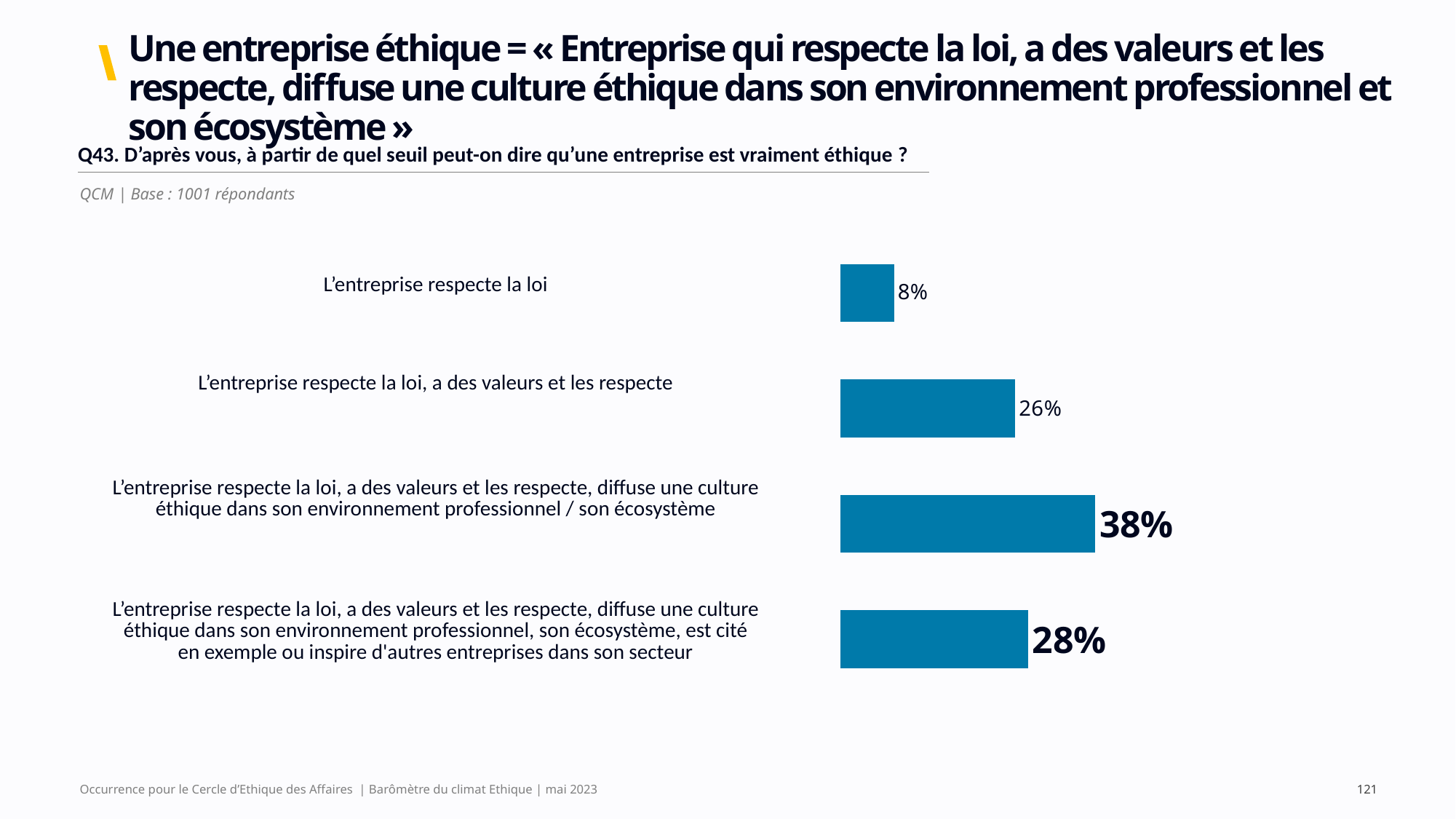
What is the value for the option where the company is also cited as an example or inspires other companies in its sector? 28% What type of chart is shown on the slide? Bar chart What percentage of respondents chose "L'entreprise respecte la loi" as the threshold for an ethical company? 8% What is the difference between the 28% option and the 26% option? 2 percentage points Which is larger: the value for "L'entreprise respecte la loi, a des valeurs et les respecte" or the value for the option that is cited as an example or inspires other companies? The option cited as an example or inspiring other companies (28%) What is the base (number of respondents) indicated for this question? 1001 répondants How many categories are shown in the chart? 4 Which category has the lowest value? L'entreprise respecte la loi What is the value for "L'entreprise respecte la loi, a des valeurs et les respecte"? 26% Which category has the highest value? L'entreprise respecte la loi, a des valeurs et les respecte, diffuse une culture éthique dans son environnement professionnel / son écosystème What percentage is shown for the option that includes diffusing an ethical culture in its professional environment / ecosystem? 38% What is the difference between the highest value (38%) and the lowest value (8%)? 30 percentage points